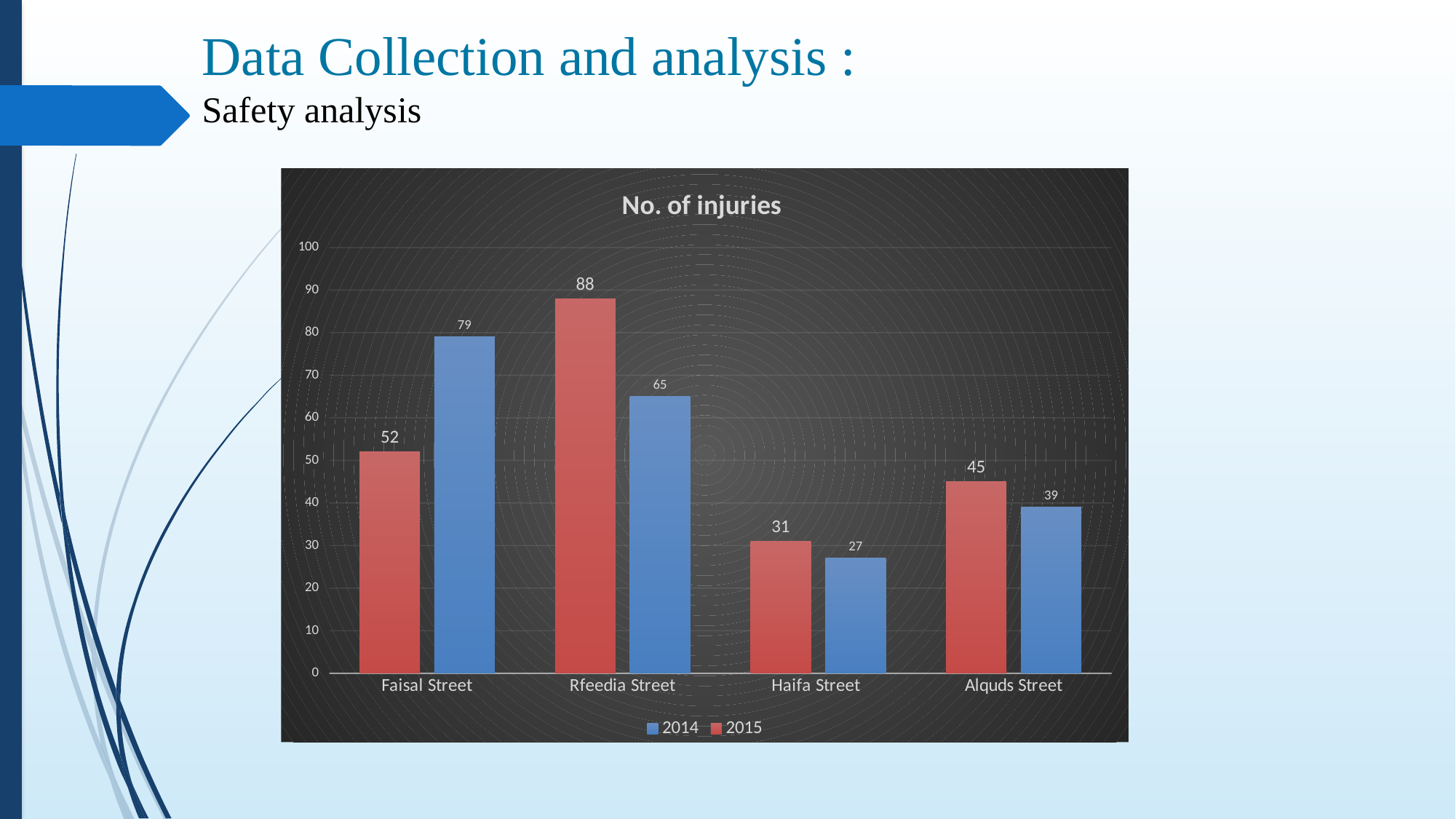
Which street has the lowest number of injuries in 2014? Haifa Street How many series does the legend list? 2 What is the number of injuries for Rfeedia Street in 2015? 88 How many streets are shown on the x axis? 4 What is the number of injuries for Haifa Street in 2014? 27 What type of chart is shown on the slide? bar chart Which colour represents the 2014 series? blue Which street has the highest number of injuries in 2015? Rfeedia Street What is the difference between the 2014 and 2015 injuries for Faisal Street? 27 What is the title of the chart? No. of injuries Which is larger for Alquds Street, the 2014 value or the 2015 value? 2015 What is the number of injuries for Faisal Street in 2014? 79